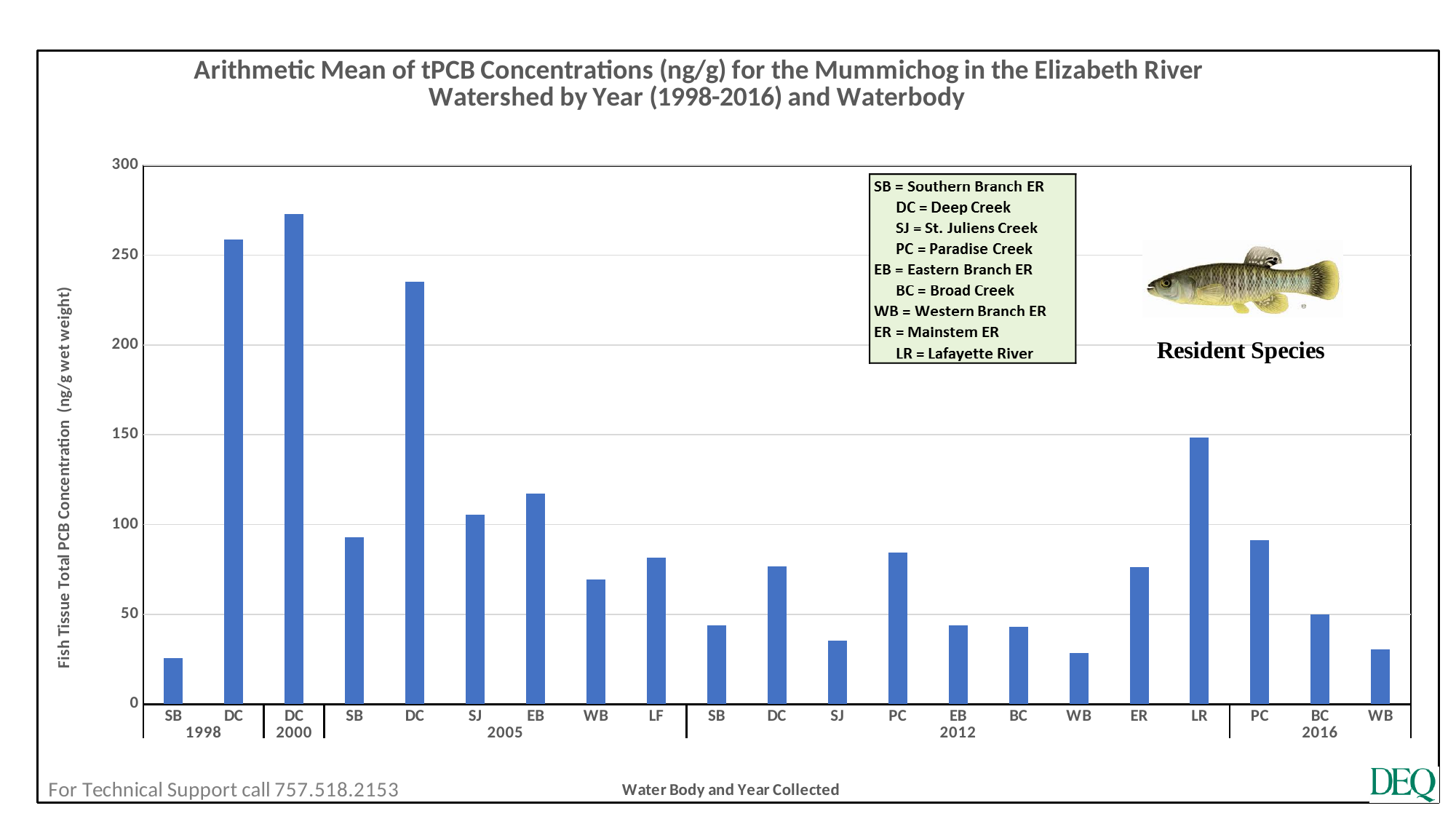
What kind of chart is shown on the slide? bar chart Which bar has the highest tPCB concentration? DC 2000 Is the value for WB in 2012 greater or less than 50? less Is the value for LR in 2012 greater or less than 100? greater Which is larger, the value for SB in 2005 or SB in 2012? SB in 2005 What does the abbreviation LR stand for in the chart's key? Lafayette River Is the value for DC in 2005 greater or less than 200? greater How many bars are plotted in the chart? 21 What is the title of the y axis? Fish Tissue Total PCB Concentration (ng/g wet weight) Which is larger, the value for DC in 1998 or DC in 2000? DC in 2000